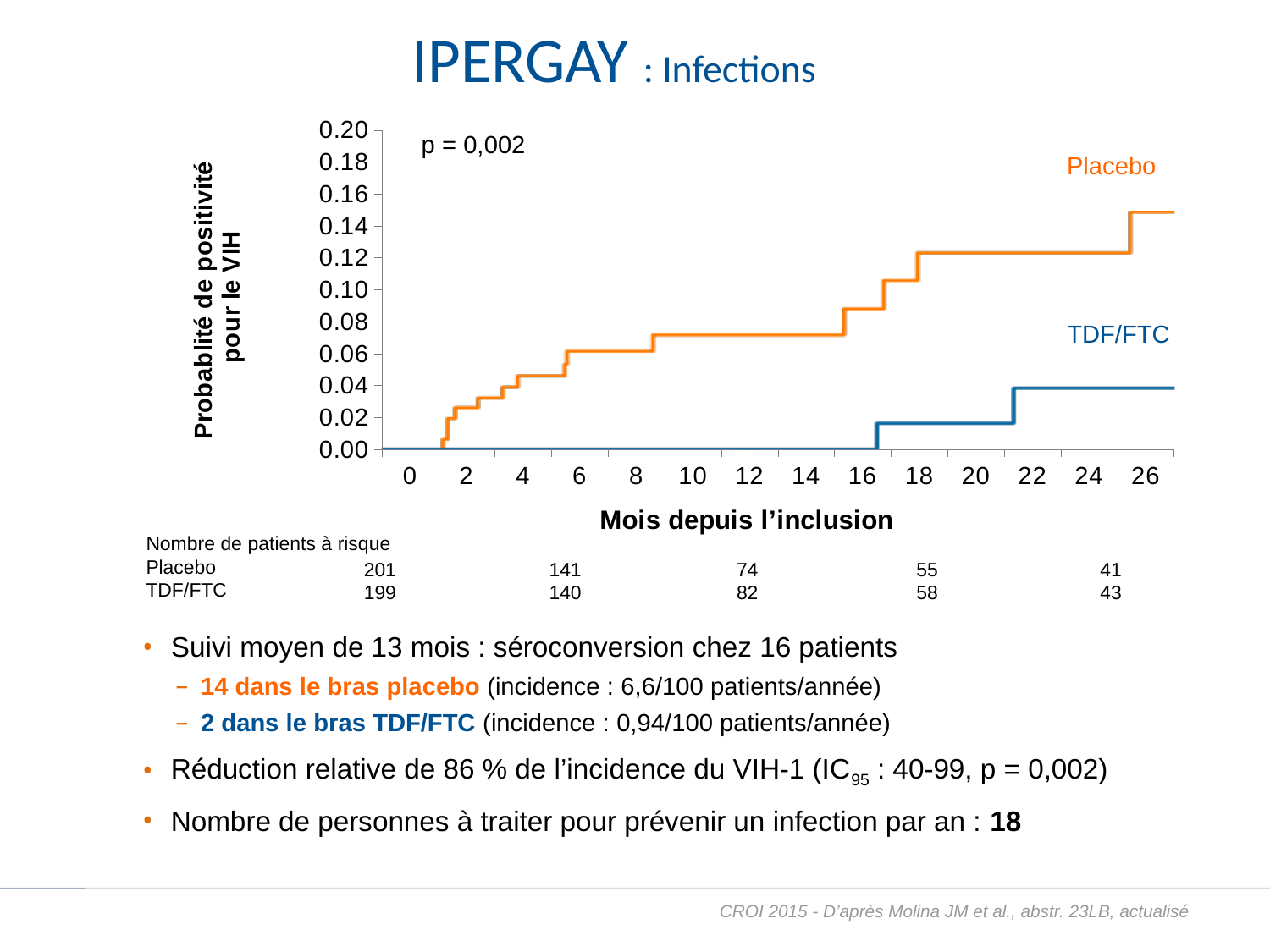
What is the label of the x axis of the chart? Mois depuis l’inclusion What p-value is printed on the chart? p = 0,002 What kind of chart is shown on the slide? line chart Is the TDF/FTC curve at month 26 greater or less than 0.06? less How many series are plotted on the chart? 2 Is the TDF/FTC curve at month 12 greater or less than 0.02? less In the number of patients at risk table, how many Placebo patients are at risk at month 0? 201 In the number of patients at risk table, how many TDF/FTC patients are at risk in the last column? 43 Do the curves rise or fall as months since inclusion increase? rise Is the Placebo curve at month 26 greater or less than 0.14? greater Which series reaches the higher probability of HIV positivity at the end of follow-up, Placebo or TDF/FTC? Placebo